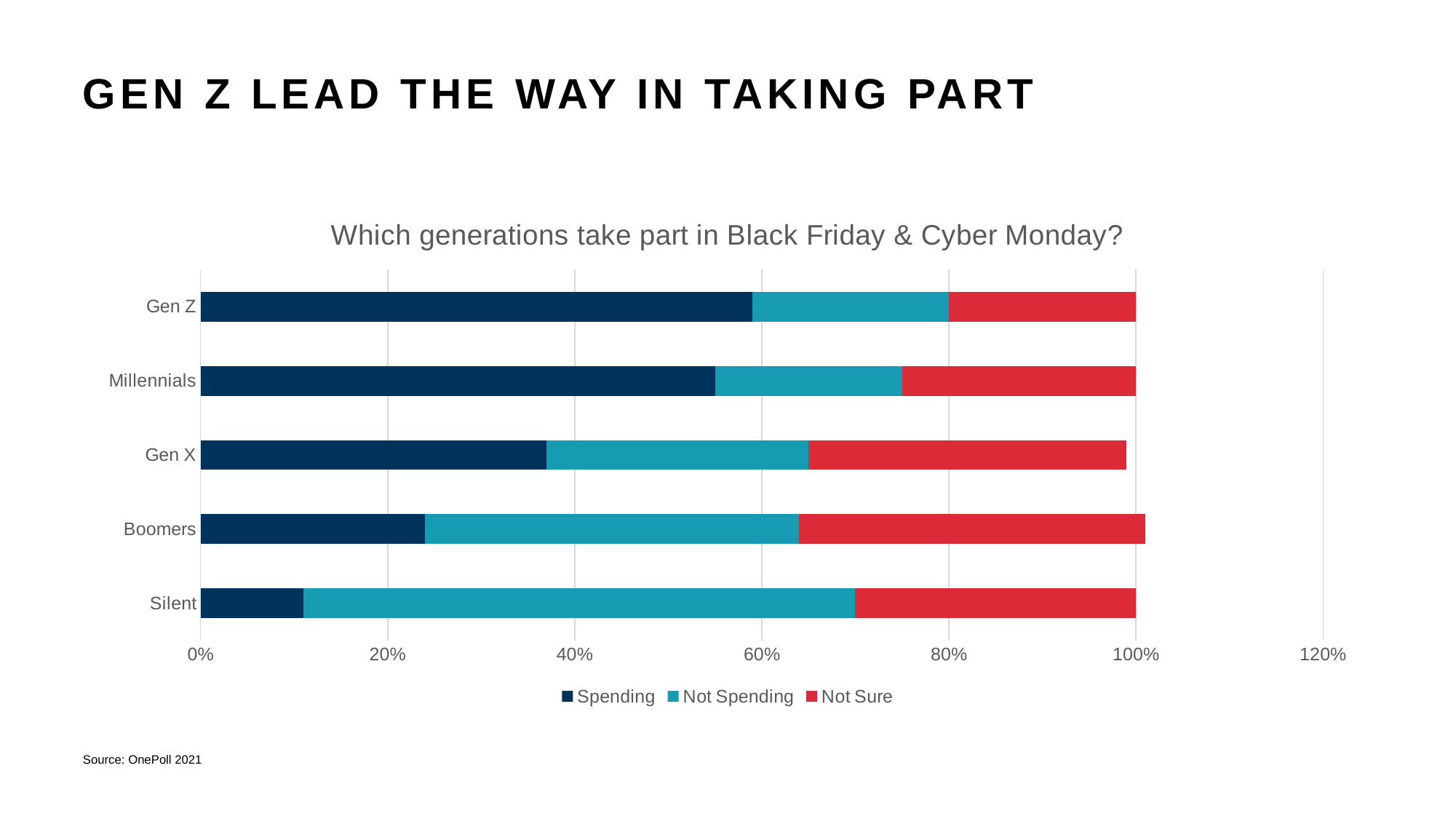
Which generation has the largest Not Spending share? Silent Which has a larger Spending share, Gen X or Boomers? Gen X Is the Spending value for Gen X greater or less than 40%? less What kind of chart is shown on the slide? Bar chart How many generations are shown on the chart? 5 Which generation has the lowest Spending share? Silent Is the Spending value for Gen Z greater or less than 40%? greater How many series does the legend list? 3 What is the title of the chart? Which generations take part in Black Friday & Cyber Monday? Is the Spending value for Silent greater or less than 20%? less Which series is shown in red in the legend? Not Sure Which generation has the highest Spending share? Gen Z